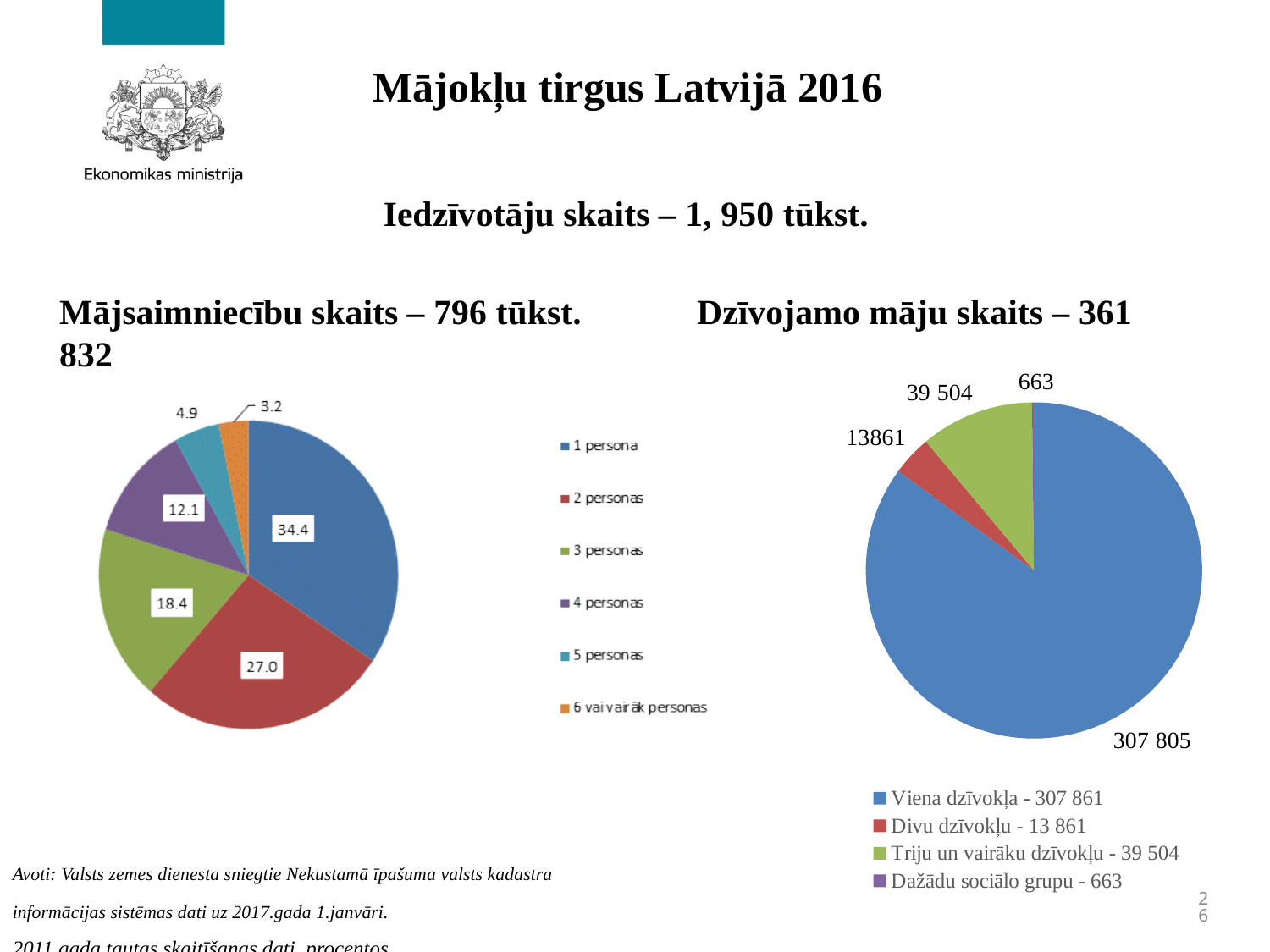
In the left chart (Mājsaimniecību skaits), which category has the largest slice? 1 persona In the right chart (Dzīvojamo māju skaits), which category has the smallest slice? Dažādu sociālo grupu In the left chart (Mājsaimniecību skaits), what is the value for 1 persona? 34.4 In the left chart (Mājsaimniecību skaits), what is the difference between the values for 2 personas and 4 personas? 14.9 In the left chart (Mājsaimniecību skaits), what is the value for 3 personas? 18.4 What type of chart is the left chart (Mājsaimniecību skaits)? pie chart In the left chart (Mājsaimniecību skaits), which is larger: the value for 4 personas or the value for 5 personas? 4 personas In the right chart (Dzīvojamo māju skaits), what value is printed on the slice for Triju un vairāku dzīvokļu? 39 504 In the right chart (Dzīvojamo māju skaits), what value is printed on the slice for Divu dzīvokļu? 13861 In the left chart (Mājsaimniecību skaits), which category has the smallest slice? 6 vai vairāk personas How many categories does the legend of the left chart (Mājsaimniecību skaits) list? 6 How many categories does the legend of the right chart (Dzīvojamo māju skaits) list? 4